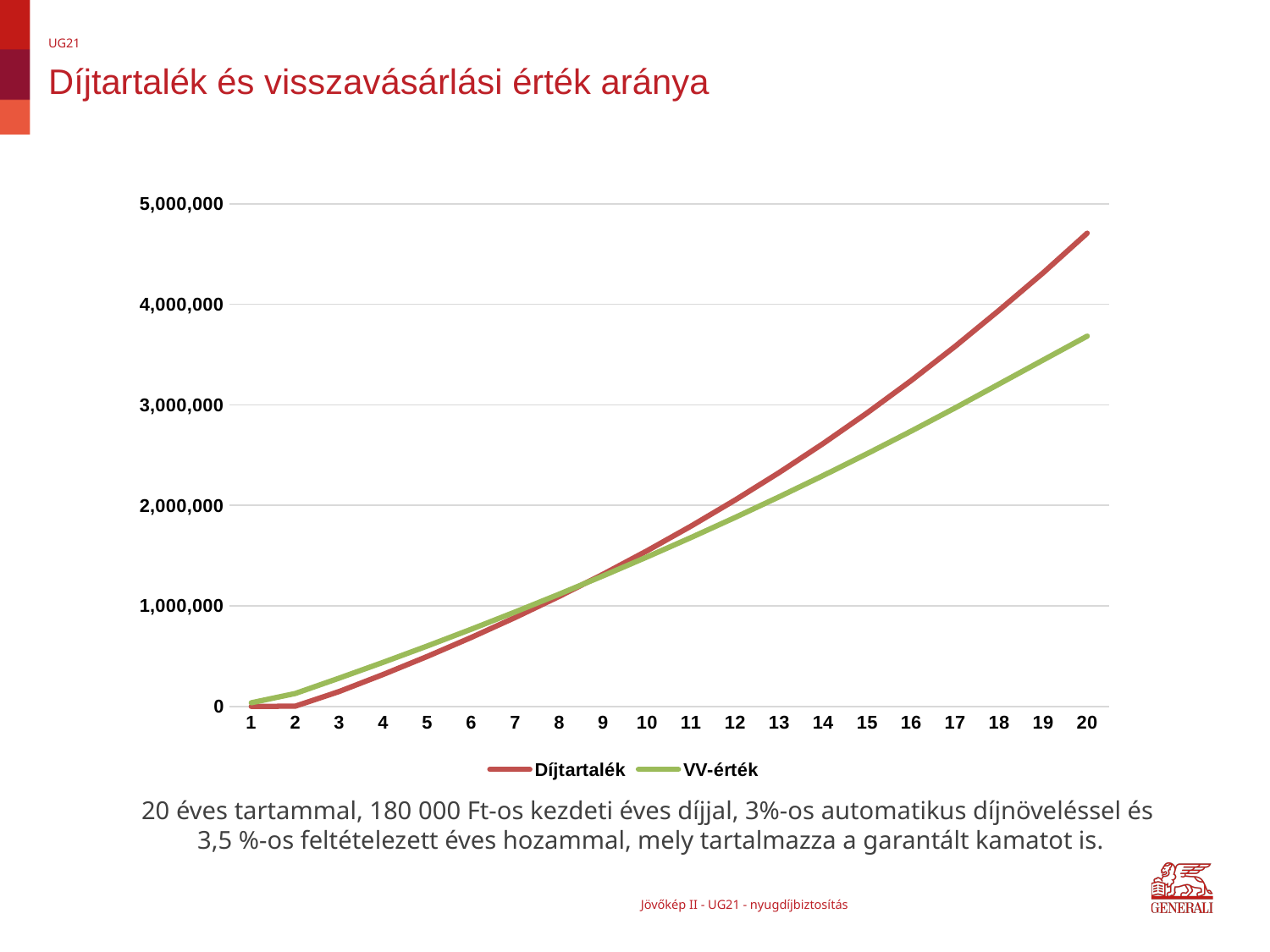
At year 5, which series has the larger value, Díjtartalék or VV-érték? VV-érték What is the title of the chart? Díjtartalék és visszavásárlási érték aránya Is the value for Díjtartalék at year 13 greater or less than 2,000,000? greater How many series does the legend list? 2 At year 20, which series has the larger value, Díjtartalék or VV-érték? Díjtartalék Which series is drawn in green? VV-érték Is the value for Díjtartalék at year 20 greater or less than 4,000,000? greater What kind of chart is shown on the slide? line chart Is the value for VV-érték at year 20 greater or less than 4,000,000? less Do the values of the Díjtartalék series rise or fall from year 1 to year 20? rise How many points are plotted along the x axis for each series? 20